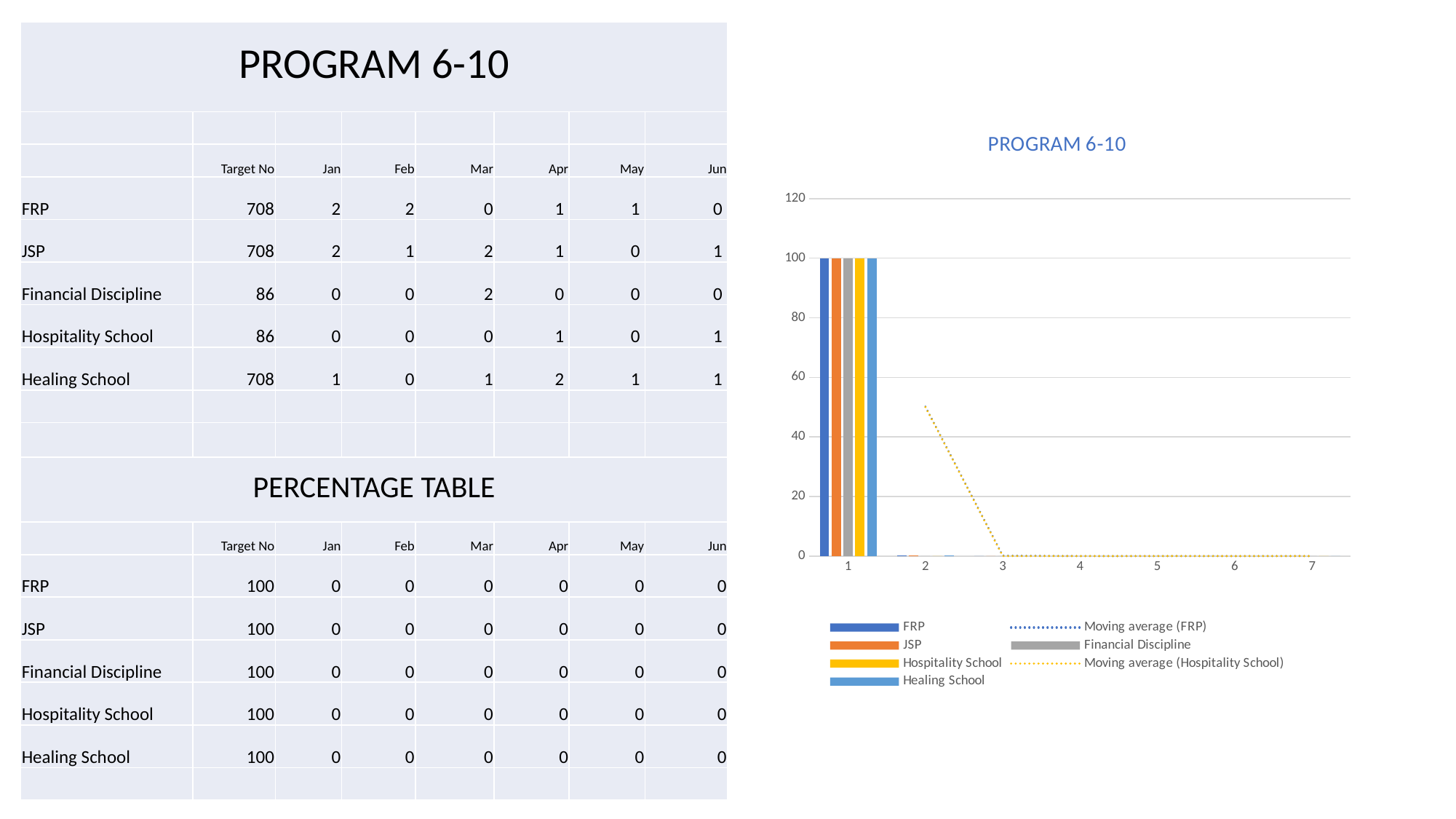
What kind of chart is shown on the slide? bar chart Which x-axis category has the tallest bars? 1 What is the title of the chart? PROGRAM 6-10 Do the bar values rise or fall from category 1 to category 2? fall What colour represents Hospitality School in the chart? yellow What is the value of the FRP bar at category 1? 100 Is the Moving average (Hospitality School) line at category 2 greater or less than 40? greater Is the value of the JSP bar at category 1 greater or less than 80? greater How many entries does the chart's legend list? 7 What is the value of the Healing School bar at category 1? 100 Is the Moving average (Hospitality School) line at category 2 greater or less than 60? less How many categories are shown on the x axis of the chart? 7